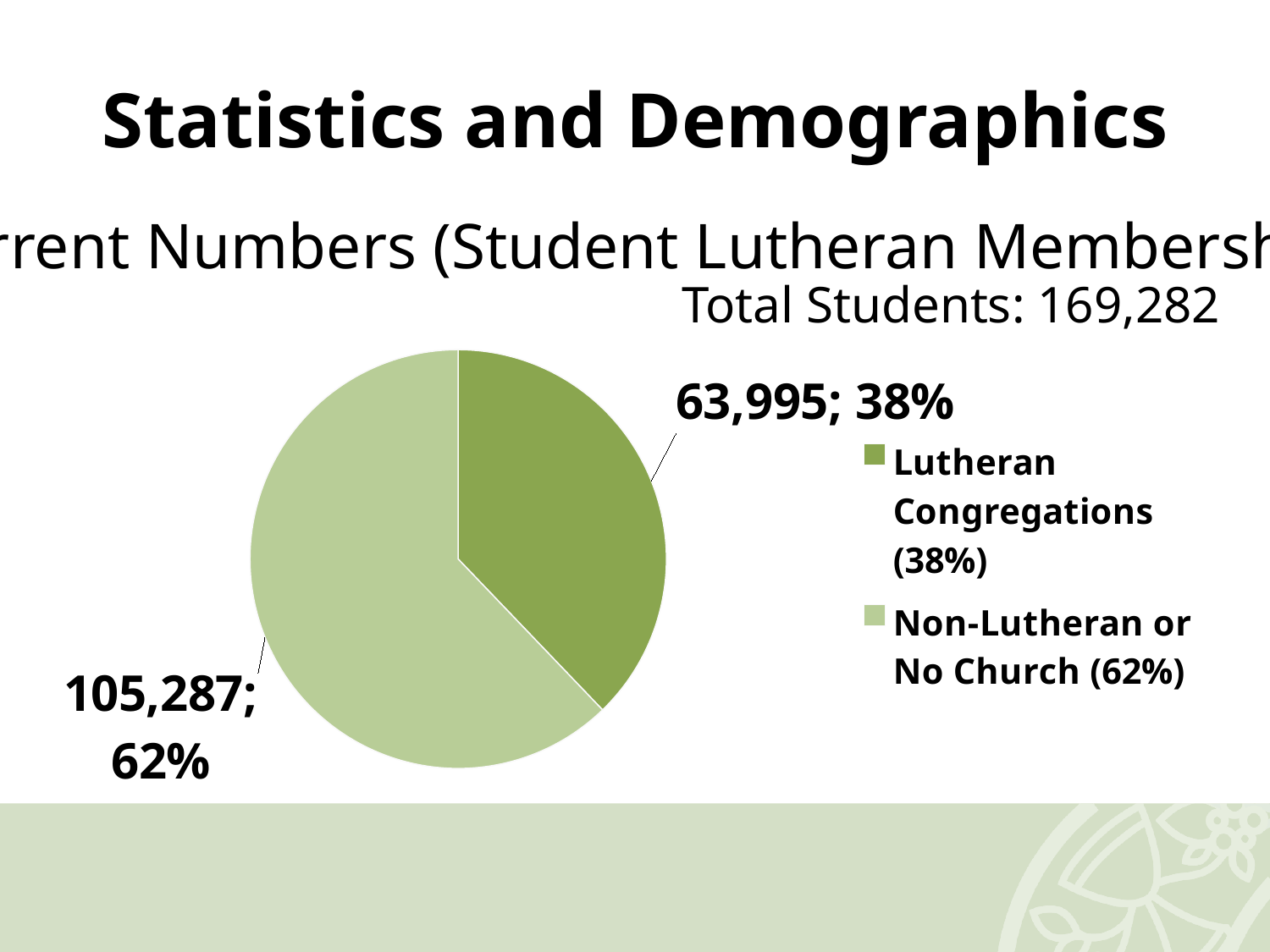
What total number of students is stated above the chart? 169,282 How many slices does the pie chart have? 2 What is the value shown for Non-Lutheran or No Church? 105,287 What kind of chart is shown on the slide? pie chart How many entries does the legend list? 2 Which slice is the largest? Non-Lutheran or No Church What is the value shown for Lutheran Congregations? 63,995 What share of the pie is Lutheran Congregations? 38% What is the difference between the Non-Lutheran or No Church value and the Lutheran Congregations value? 41,292 Which slice is the smallest? Lutheran Congregations Which is larger, Lutheran Congregations or Non-Lutheran or No Church? Non-Lutheran or No Church What share of the pie is Non-Lutheran or No Church? 62%